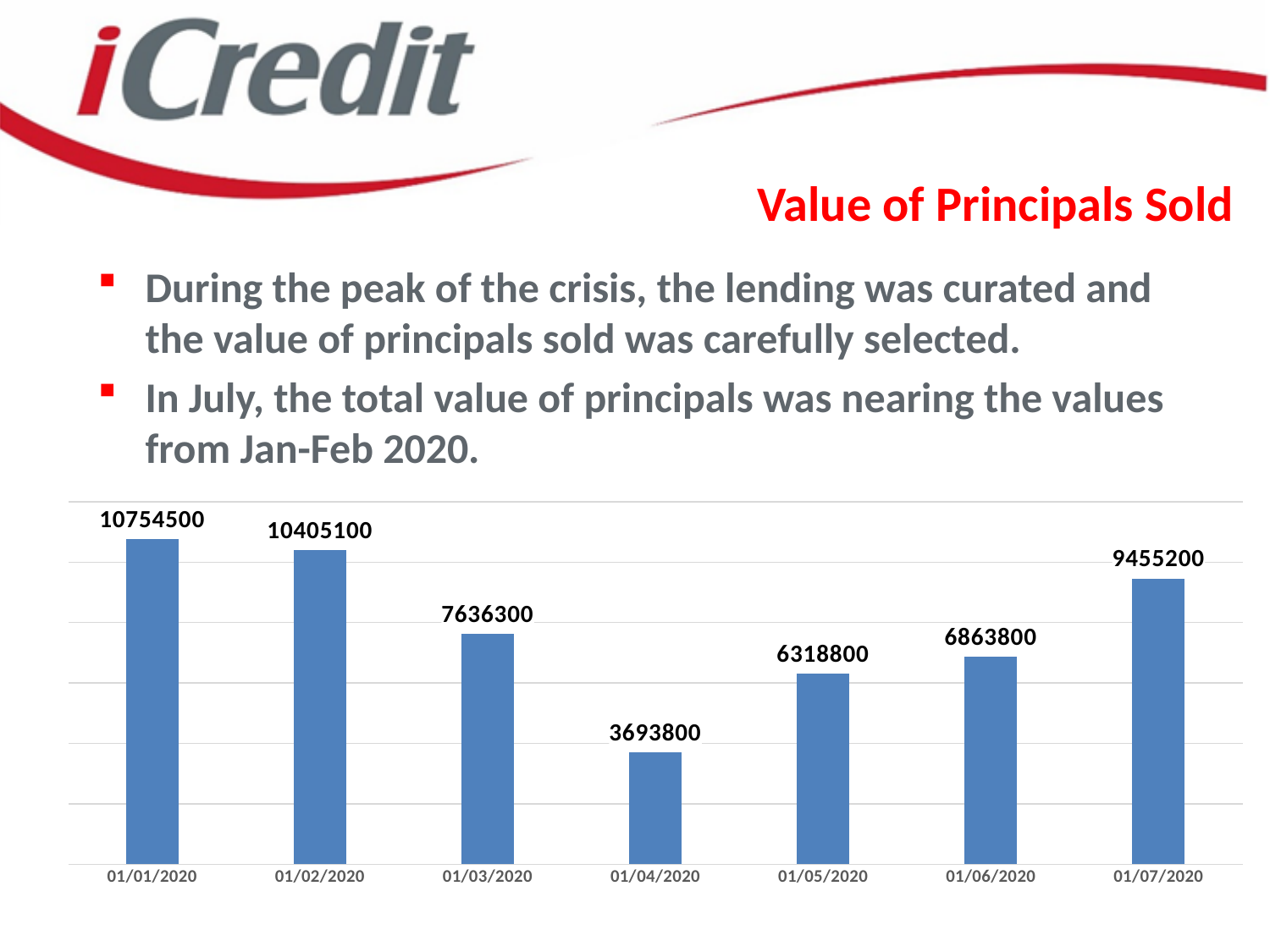
What is the value for 01/03/2020? 7636300 What is the value for 01/07/2020? 9455200 What is the difference between the values for 01/01/2020 and 01/02/2020? 349400 How many dates are shown on the x axis? 7 What is the difference between the values for 01/07/2020 and 01/04/2020? 5761400 Which date has the lowest value? 01/04/2020 Which date has the highest value? 01/01/2020 What is the value for 01/04/2020? 3693800 Do the values rise or fall from 01/04/2020 to 01/07/2020? rise What kind of chart is shown on the slide? bar chart Which is larger, the value for 01/03/2020 or 01/07/2020? 01/07/2020 Which is larger, the value for 01/05/2020 or 01/06/2020? 01/06/2020